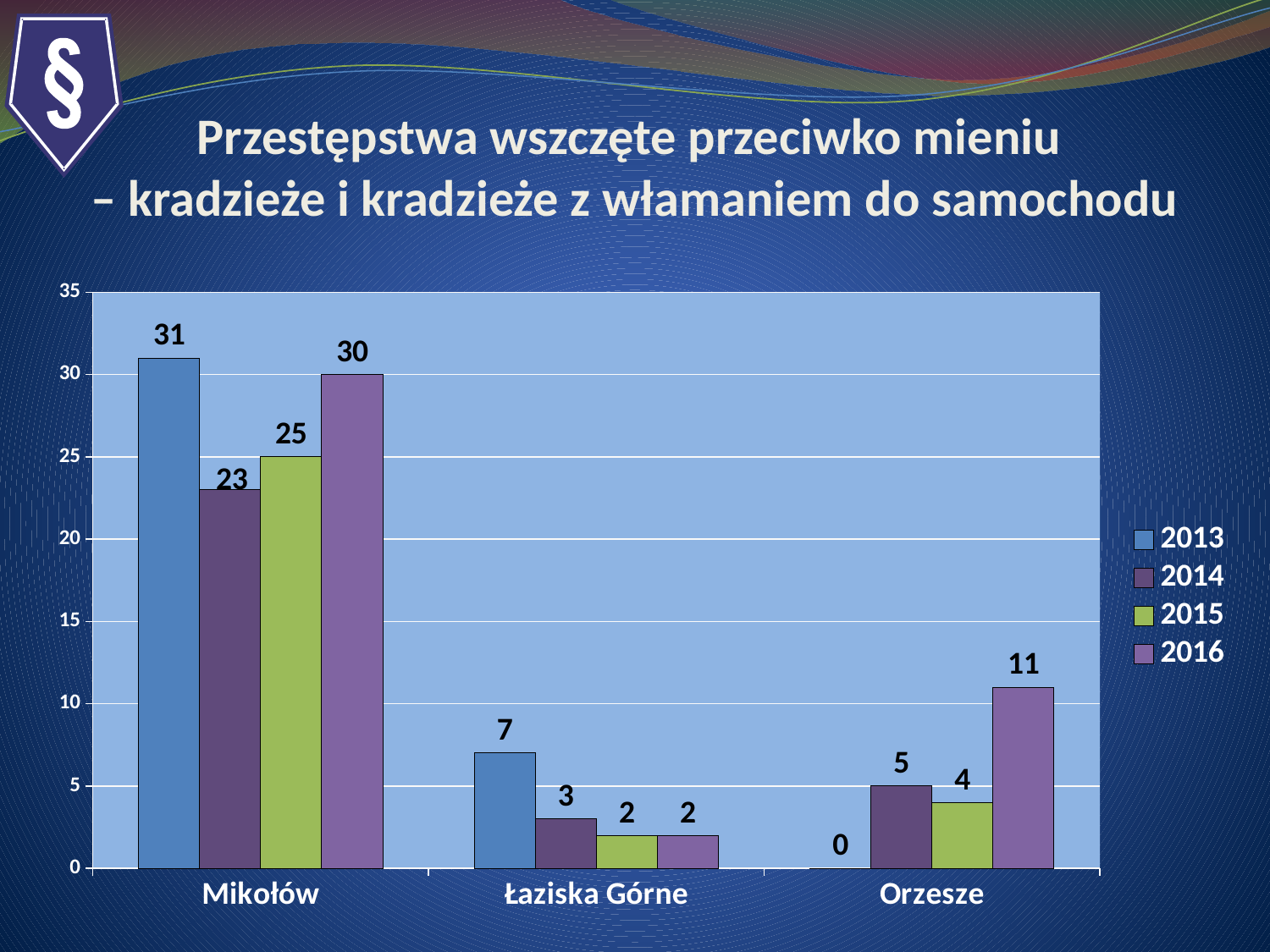
What is the value for Łaziska Górne in 2014? 3 Do the values for Łaziska Górne rise or fall from 2013 to 2015? Fall How many categories are shown on the x axis? 3 Which year has the highest value for Mikołów? 2013 How many series does the legend list? 4 What is the difference between the 2013 and 2014 values for Mikołów? 8 What is the value for Orzesze in 2016? 11 What is the value for Mikołów in 2013? 31 What kind of chart is shown on the slide? Bar chart Which year has the lowest value for Orzesze? 2013 What is the value for Orzesze in 2013? 0 Which is larger: the 2015 value for Orzesze or the 2015 value for Łaziska Górne? Orzesze